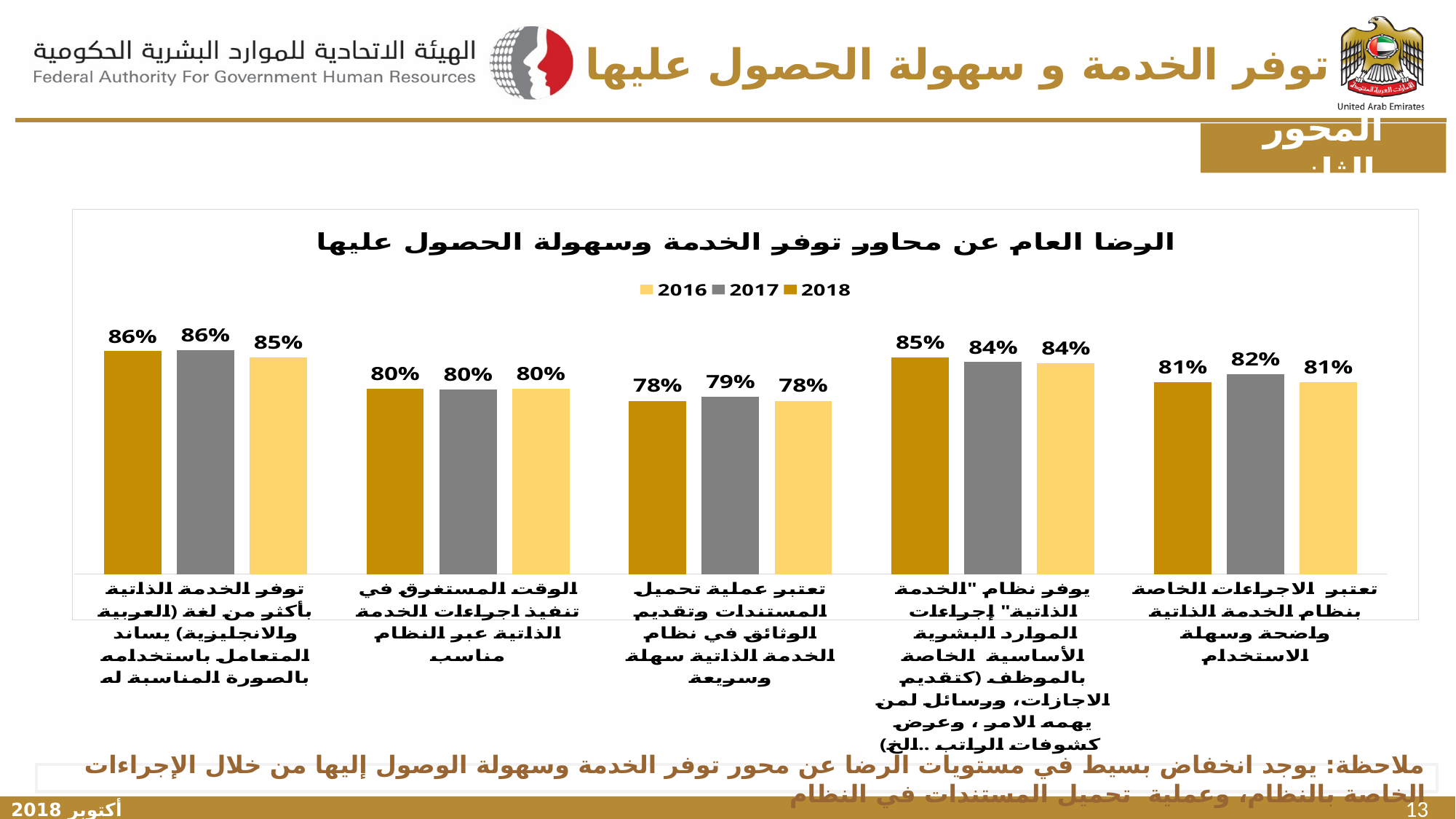
How many series does the chart legend list? 3 What are the 2016, 2017 and 2018 values for the category 'الوقت المستغرق في تنفيذ اجراءات الخدمة الذاتية عبر النظام مناسب'? 80%, 80%, 80% What type of chart is shown on the slide? Bar chart What is the 2018 value for the category 'توفر الخدمة الذاتية بأكثر من لغة (العربية والانجليزية)'? 86% Which years are listed in the chart legend? 2016, 2017, 2018 What is the 2017 value for the category 'تعتبر عملية تحميل المستندات وتقديم الوثائق في نظام الخدمة الذاتية سهلة وسريعة'? 79% Which category has the lowest 2018 value? تعتبر عملية تحميل المستندات وتقديم الوثائق في نظام الخدمة الذاتية سهلة وسريعة What is the 2017 value for the category 'تعتبر الاجراءات الخاصة بنظام الخدمة الذاتية واضحة وسهلة الاستخدام'? 82% What is the difference between the 2018 value for 'توفر الخدمة الذاتية بأكثر من لغة' (86%) and the 2018 value for 'تعتبر عملية تحميل المستندات' (78%)? 8% What is the 2018 value for the category 'يوفر نظام الخدمة الذاتية إجراءات الموارد البشرية الأساسية الخاصة بالموظف'? 85% What is the 2016 value for the category 'توفر الخدمة الذاتية بأكثر من لغة (العربية والانجليزية)'? 85% How many categories are shown on the x axis of the chart? 5